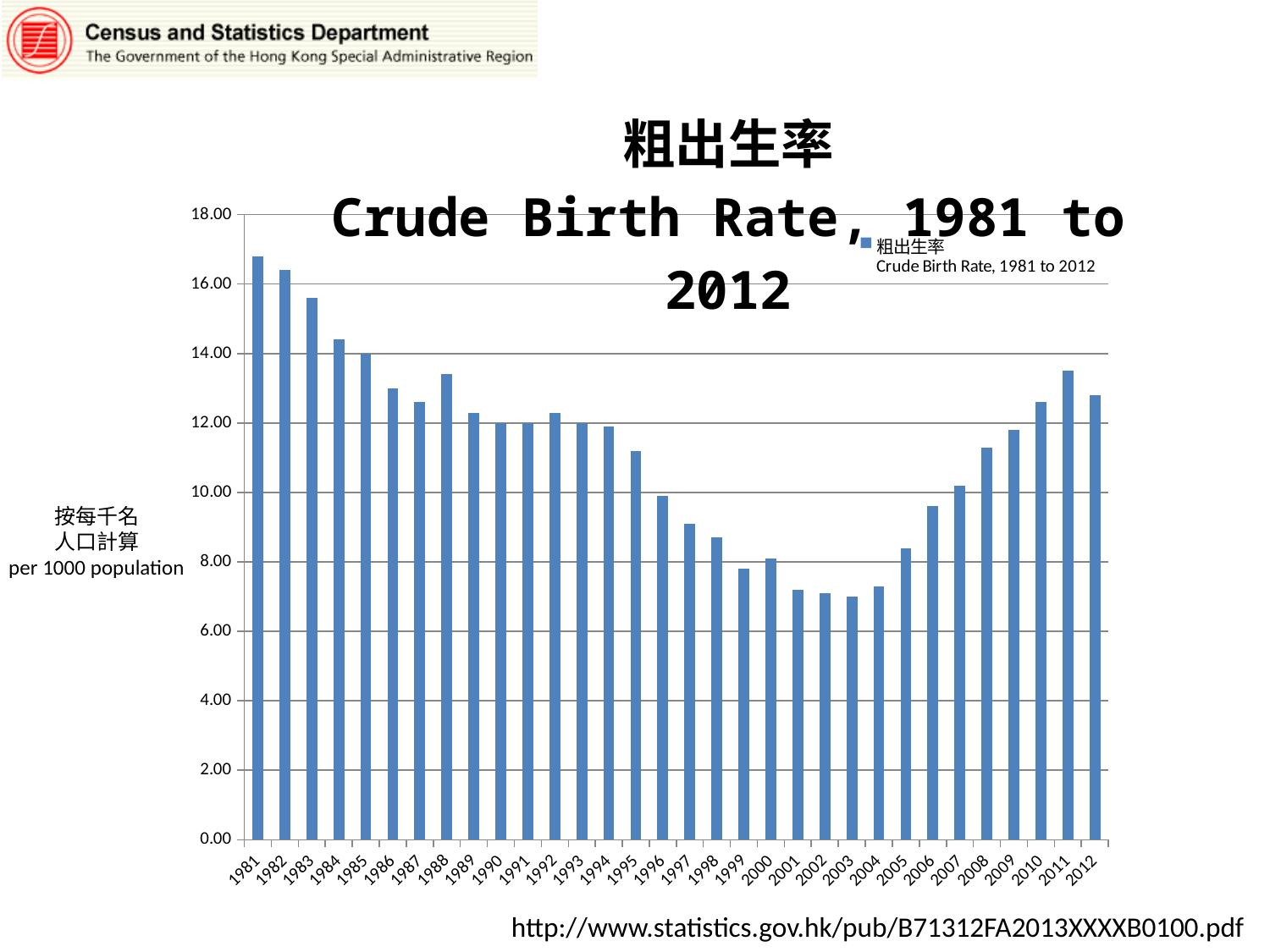
Which is larger, the value for 2010 or the value for 2011? 2011 How many years are plotted on the x axis of the chart? 32 What kind of chart is shown on the slide? bar chart What unit is given on the left of the chart for the crude birth rate? per 1000 population Is the value for 2011 greater or less than 12.00? greater Which is larger, the value for 1981 or the value for 2012? 1981 Do the values rise or fall from 1981 to 1990? fall Is the value for 2003 greater or less than 8.00? less How many series does the legend list? 1 Which year has the highest crude birth rate? 1981 Is the value for 1981 greater or less than 16.00? greater